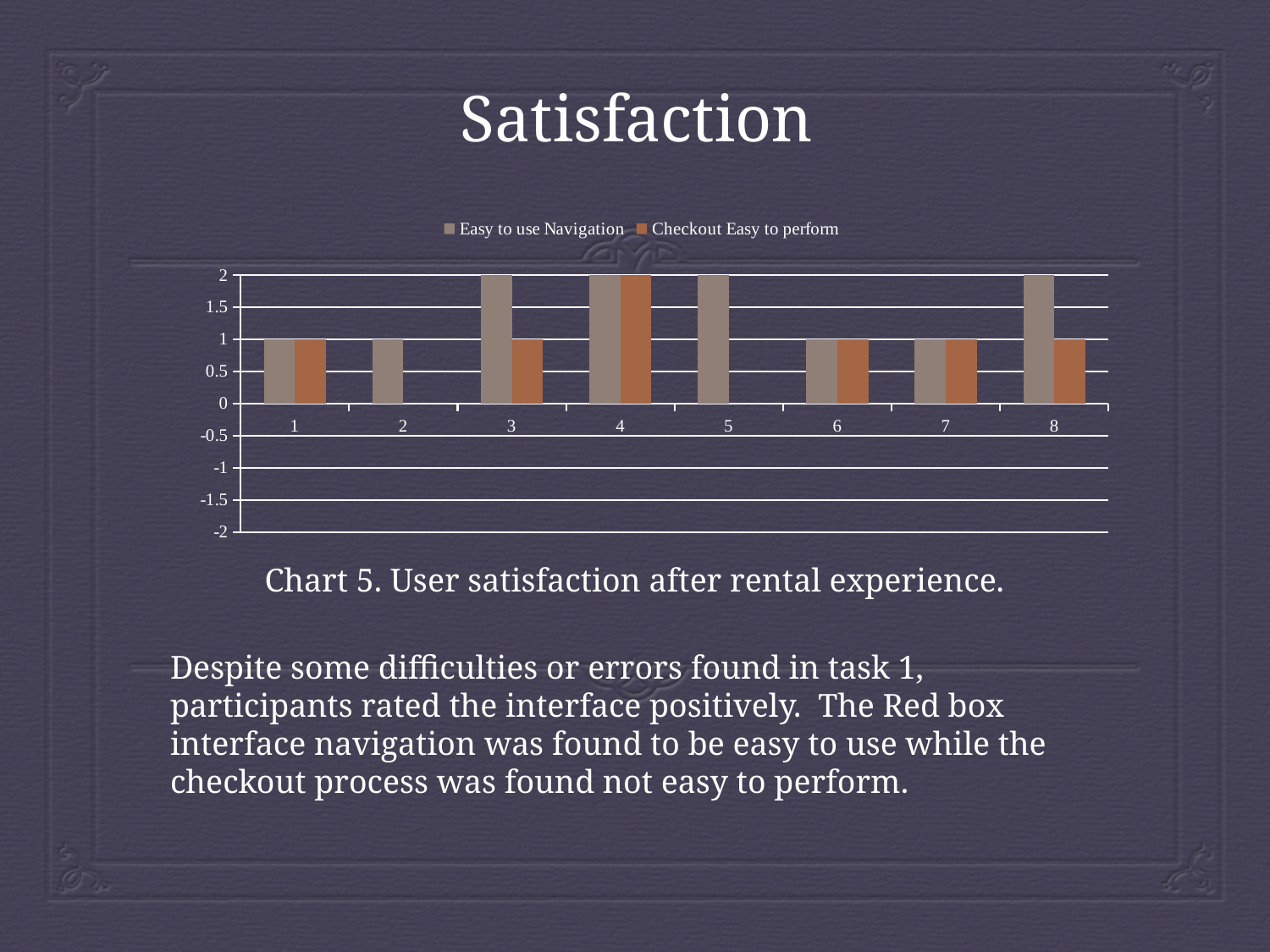
What is the value of Easy to use Navigation for category 3? 2 Is the value of Easy to use Navigation for category 4 greater or less than 1? greater What is the caption given below the chart? Chart 5. User satisfaction after rental experience. What is the value of Easy to use Navigation for category 6? 1 How many categories are shown on the x axis? 8 Which is larger for category 5, Easy to use Navigation or Checkout Easy to perform? Easy to use Navigation What is the value of Checkout Easy to perform for category 4? 2 What is the highest value shown on the y axis? 2 How many series does the legend list? 2 What kind of chart is shown on the slide? Bar chart What is the value of Checkout Easy to perform for category 8? 1 What is the difference between Easy to use Navigation and Checkout Easy to perform for category 3? 1